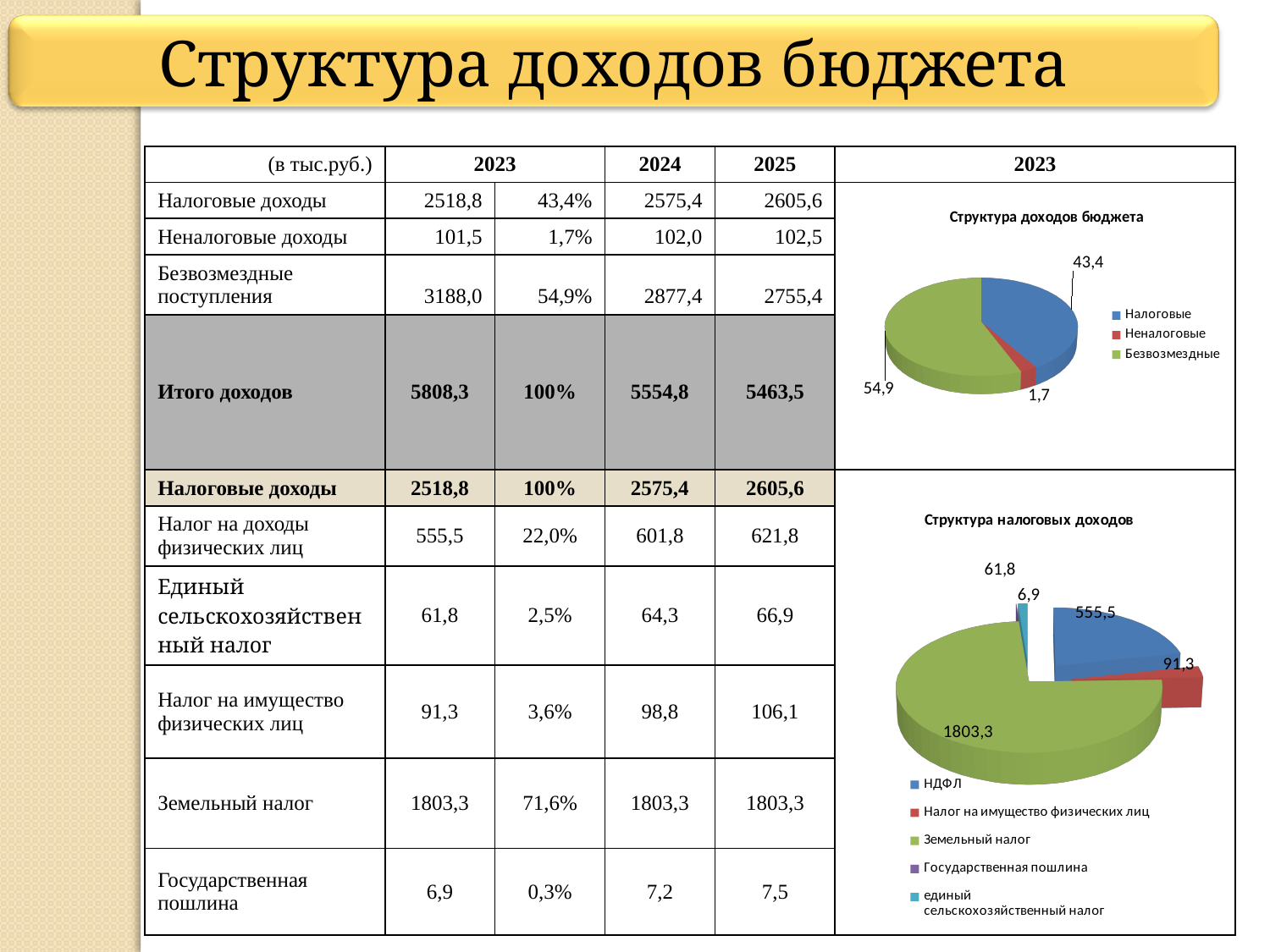
In the chart titled "Структура налоговых доходов", how many categories does the legend list? 5 In the chart titled "Структура доходов бюджета", what value is shown for the Безвозмездные slice? 54,9 In the chart titled "Структура доходов бюджета", which category has the largest slice? Безвозмездные In the chart titled "Структура доходов бюджета", what is the difference between the Безвозмездные and Налоговые values? 11,5 In the chart titled "Структура доходов бюджета", what colour is the Налоговые slice? Blue In the chart titled "Структура налоговых доходов", what value is shown for Земельный налог? 1803,3 In the chart titled "Структура налоговых доходов", which is larger: Налог на имущество физических лиц or единый сельскохозяйственный налог? Налог на имущество физических лиц In the chart titled "Структура налоговых доходов", what value is shown for НДФЛ? 555,5 In the chart titled "Структура доходов бюджета", which category has the smallest slice? Неналоговые In the chart titled "Структура налоговых доходов", which category has the smallest value? Государственная пошлина In the chart titled "Структура доходов бюджета", what value is shown for the Налоговые slice? 43,4 What type of chart is "Структура налоговых доходов"? Pie chart